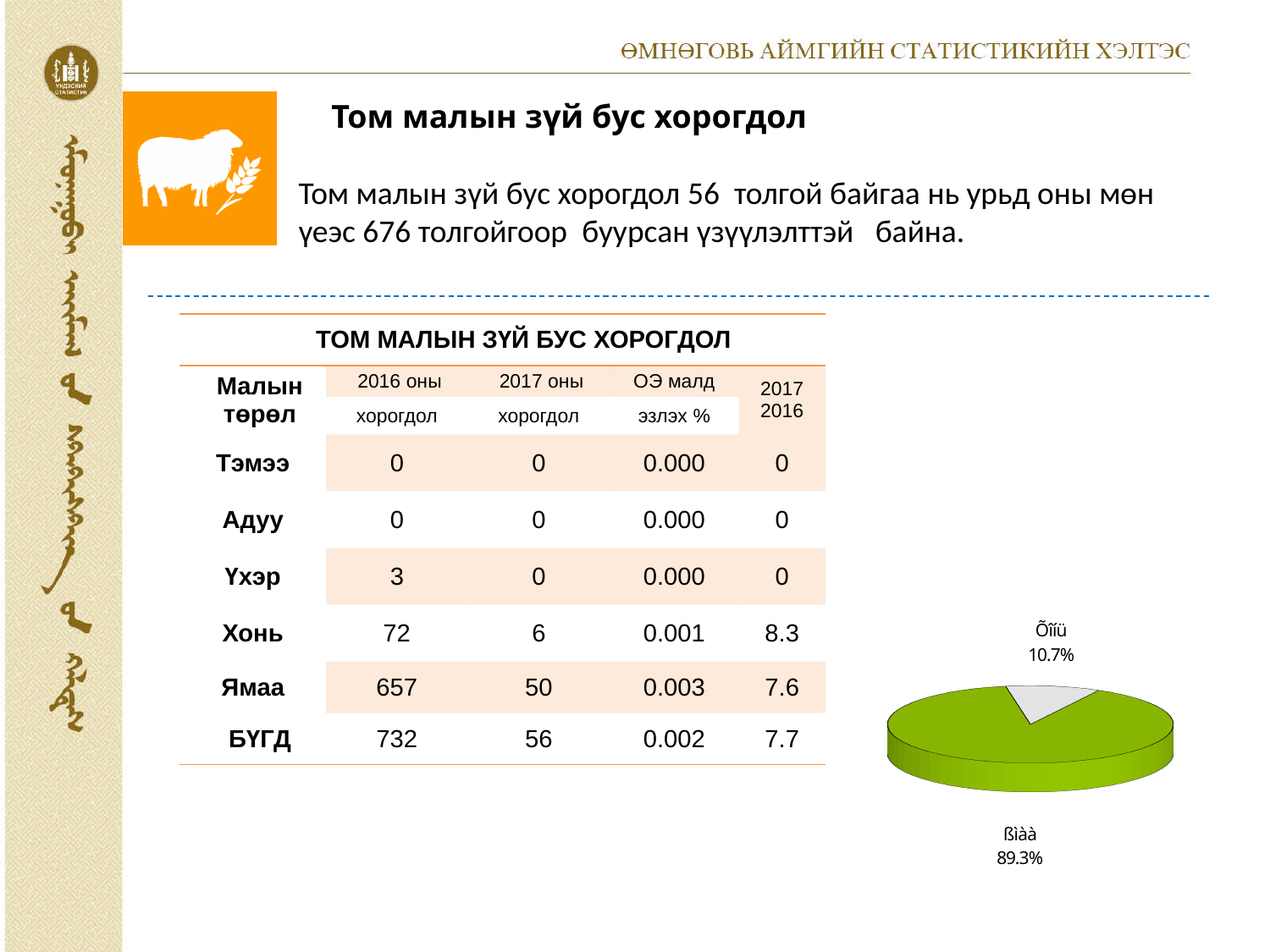
What share of the pie chart does the largest slice represent? 89.3% What kind of chart is shown on the right side of the slide? pie chart What share of the pie chart does the smallest slice represent? 10.7% What is the difference in percentage points between the two slices of the pie chart? 78.6 What percentage is shown for the slice labelled "Õîíü" in the pie chart? 10.7% Is the share of the green slice in the pie chart greater or less than 50%? greater What percentage is shown for the grey slice of the pie chart? 10.7% Which slice of the pie chart is larger, the green one or the grey one? the green one What percentage is shown for the slice labelled "ßìàà" in the pie chart? 89.3% What percentage is shown for the green slice of the pie chart? 89.3% How many slices does the pie chart have? 2 What colour is the largest slice of the pie chart? green